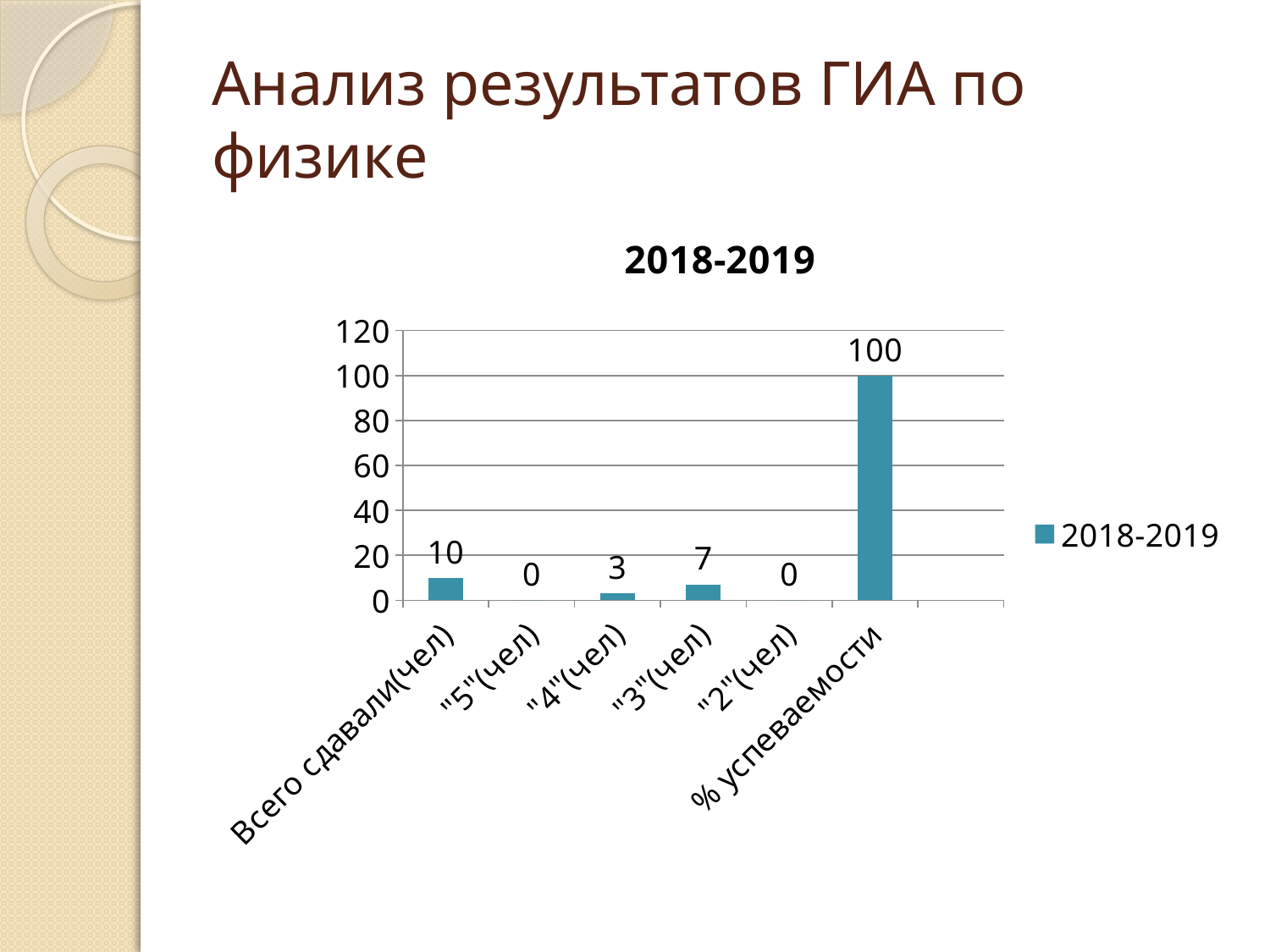
What is the value for "3"(чел)? 7 Is the value for "% успеваемости" greater or less than 80? greater What is the difference between the values for "3"(чел) and "4"(чел)? 4 What is the value for "% успеваемости"? 100 Which is larger, the value for "3"(чел) or the value for "4"(чел)? "3"(чел) What is the title of the chart? 2018-2019 Which category has the highest value? % успеваемости How many categories are shown on the x axis? 6 What is the value for "4"(чел)? 3 What is the value for "Всего сдавали(чел)"? 10 What kind of chart is shown on the slide? bar chart How many series does the legend list? 1